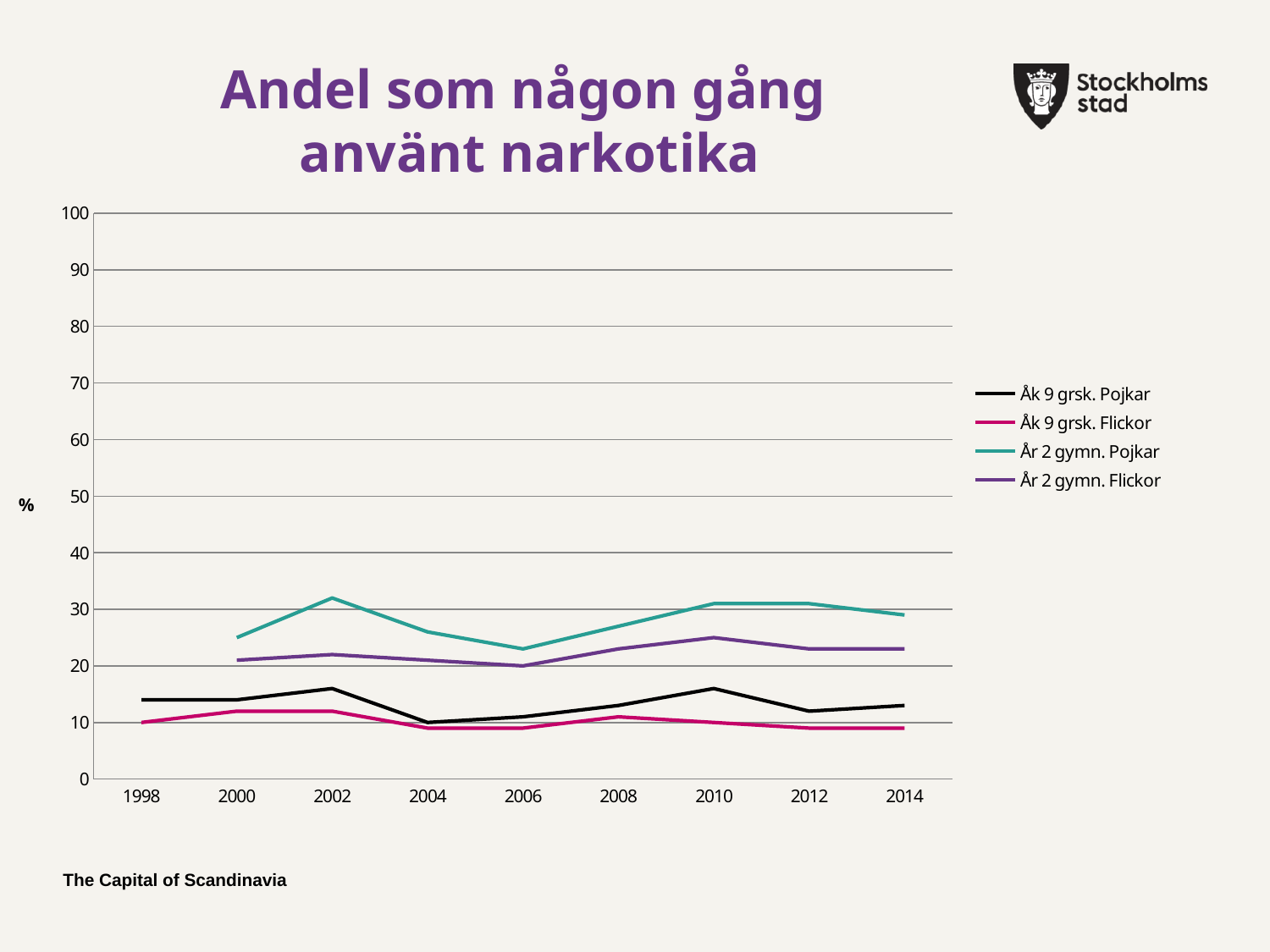
What kind of chart is shown on the slide? line chart Is the value for År 2 gymn. Pojkar in 2002 greater or less than 30? greater Is the value for År 2 gymn. Pojkar in 2006 greater or less than 30? less Does the value for År 2 gymn. Pojkar rise or fall from 2000 to 2002? rise Which series has the highest values across the chart? År 2 gymn. Pojkar In 2010, which is larger: the value for År 2 gymn. Pojkar or for Åk 9 grsk. Pojkar? År 2 gymn. Pojkar Is the value for År 2 gymn. Flickor in 2010 greater or less than 20? greater How many series does the legend list? 4 How many years are shown on the x axis? 9 What is the title of the chart? Andel som någon gång använt narkotika Which series has the lowest values across the chart? Åk 9 grsk. Flickor